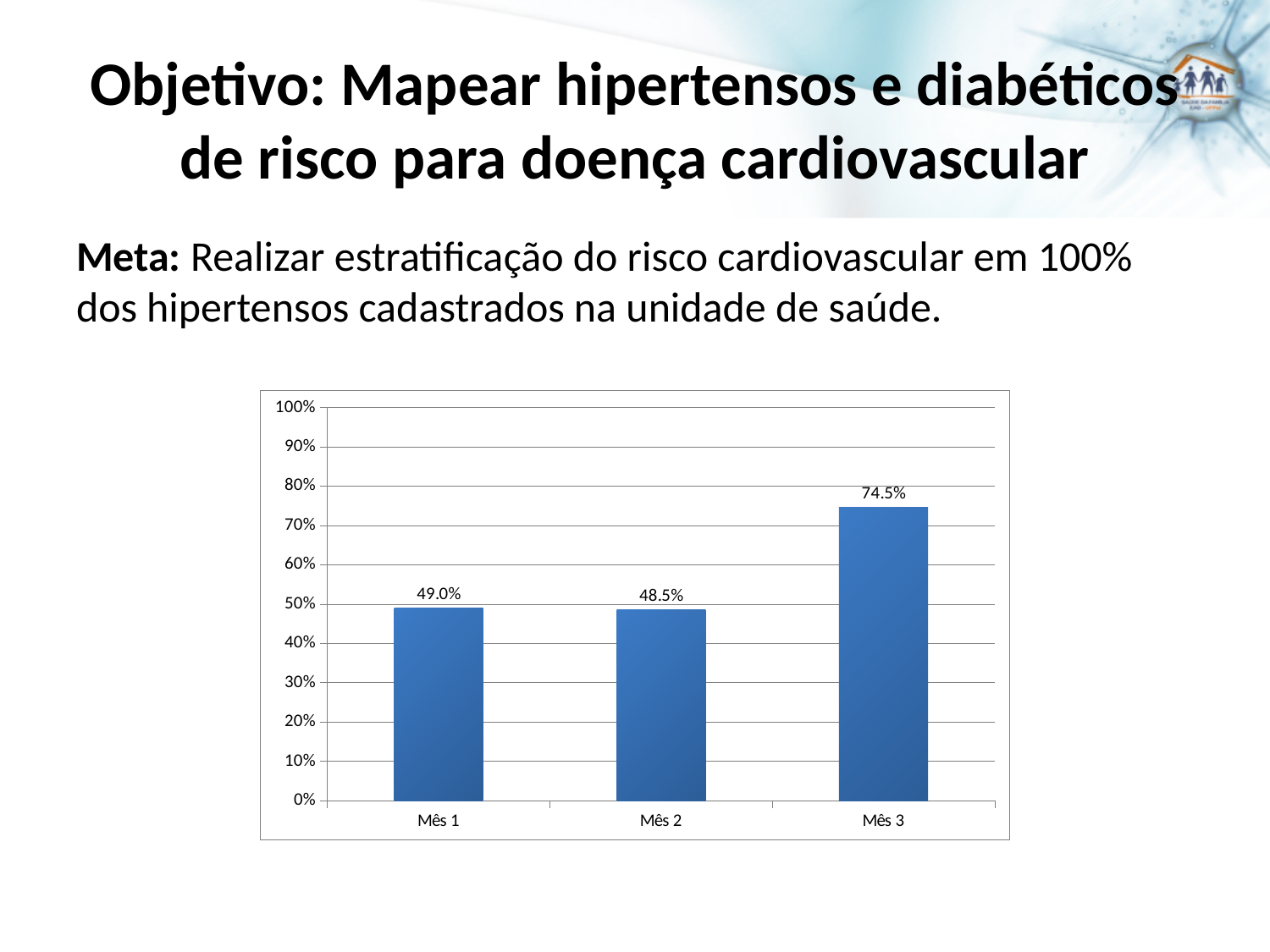
Which month has the highest value? Mês 3 What kind of chart is shown on the slide? bar chart Which is larger, the value for Mês 3 or the value for Mês 2? Mês 3 What is the difference between the values for Mês 1 and Mês 2? 0.5% Is the value for Mês 3 greater or less than 70%? greater What is the value for Mês 3? 74.5% What is the value for Mês 1? 49.0% What is the value for Mês 2? 48.5% How many months are shown on the x axis? 3 What is the difference between the values for Mês 3 and Mês 1? 25.5% What is the highest value shown on the y axis? 100% Which month has the lowest value? Mês 2